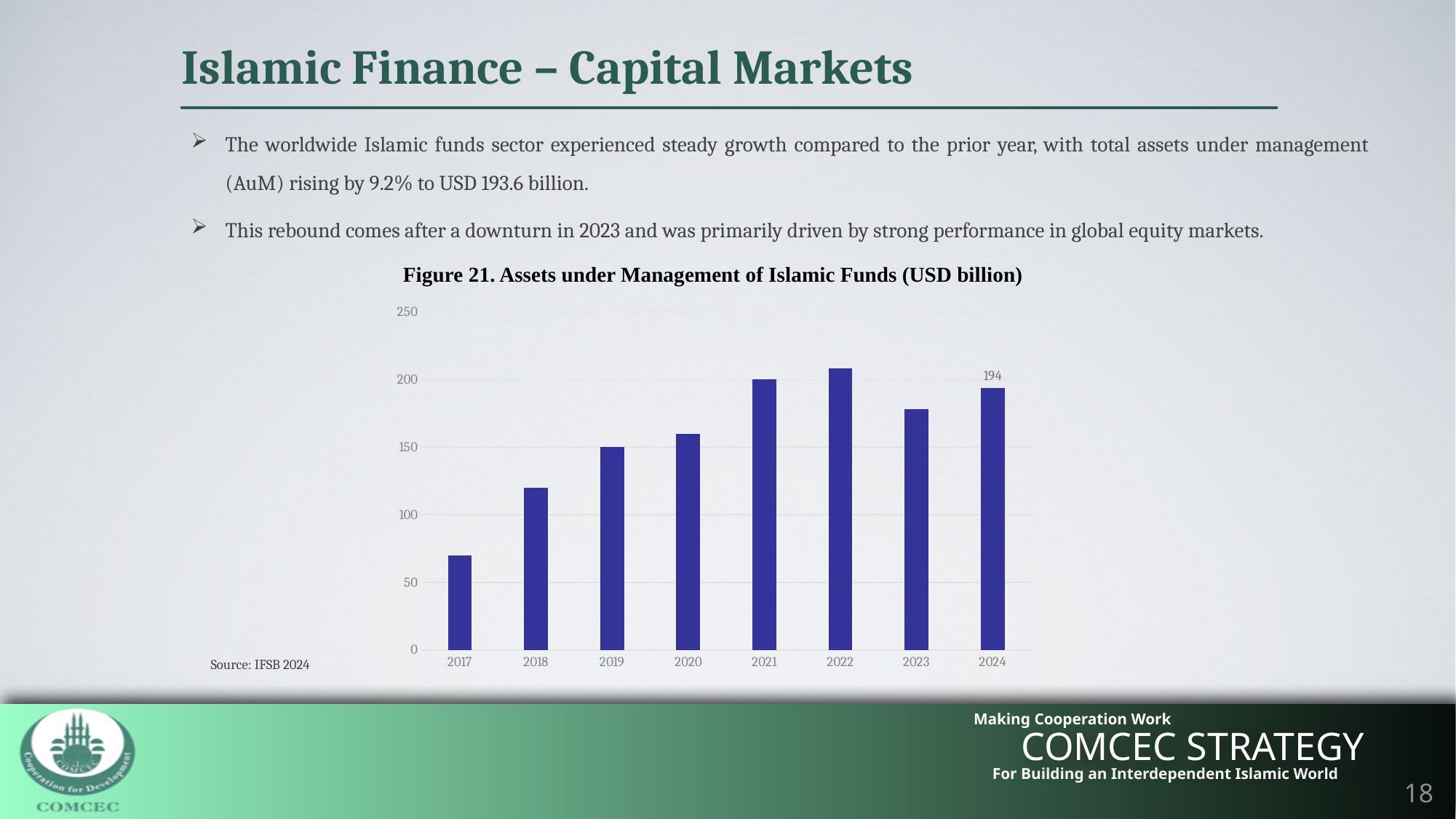
Which is larger, the value for 2021 or the value for 2023? 2021 How many years are shown on the x axis of the chart? 8 What is the value for 2024 in the chart? 194 Which year has the lowest assets under management in the chart? 2017 Is the value for 2023 greater or less than 200? less Do the values rise or fall from 2017 to 2022? Rise Is the value for 2018 greater or less than 100? greater What is the title of the chart? Figure 21. Assets under Management of Islamic Funds (USD billion) Which is larger, the value for 2018 or the value for 2020? 2020 Which year has the highest assets under management in the chart? 2022 What kind of chart is shown on the slide? Bar chart Is the value for 2017 greater or less than 100? less